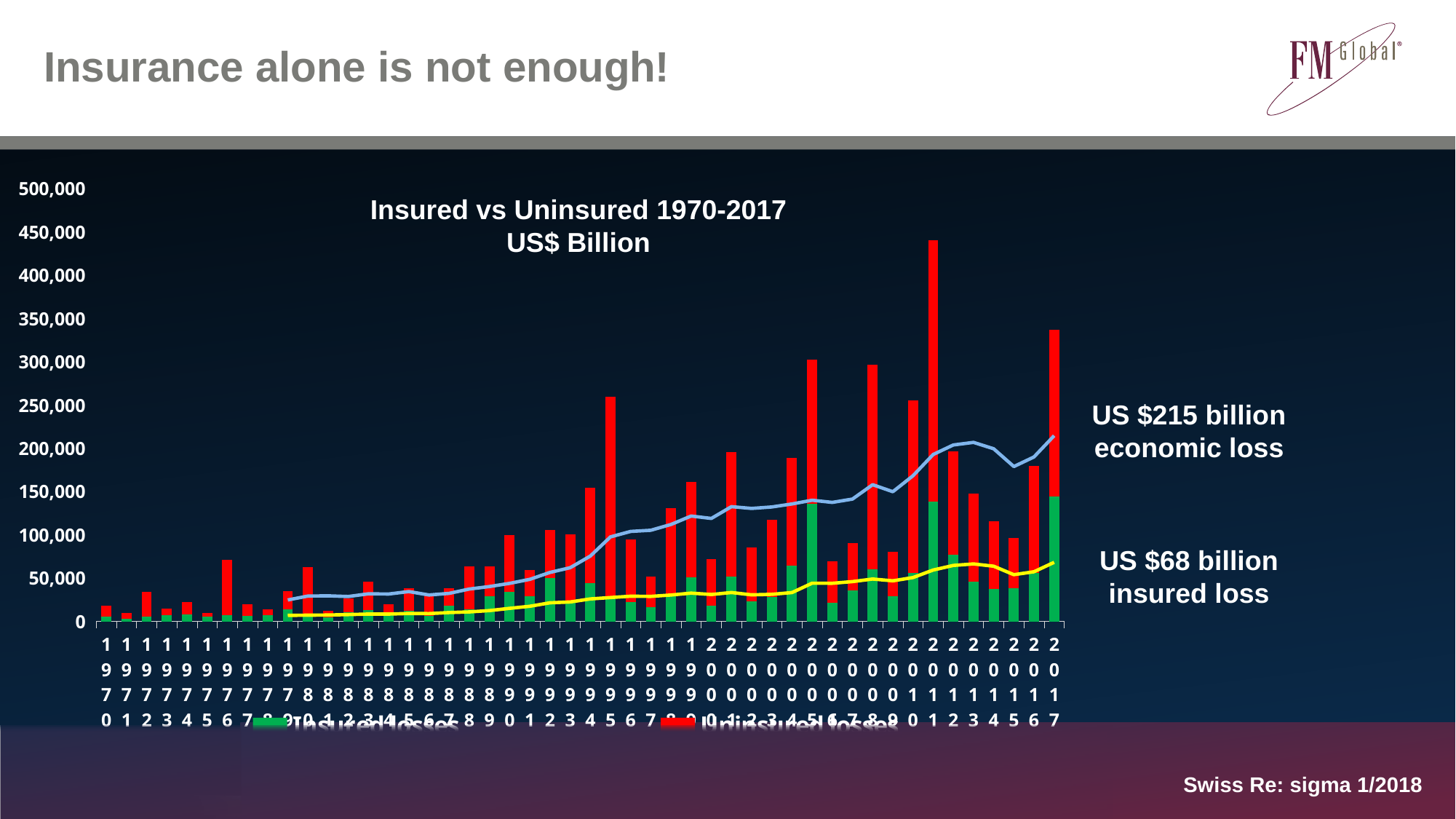
What kind of chart is shown on the slide? bar and line chart Is the total bar value for 2017 greater or less than 300,000? greater What economic loss figure is annotated next to the chart? US $215 billion Do the bar values generally rise or fall from 1970 to 2017? rise Is the total bar value for 1970 greater or less than 50,000? less Which year has the tallest bar in the chart? 2011 What is the title of the chart? Insured vs Uninsured 1970-2017 US$ Billion Which year has the larger total bar, 2011 or 2017? 2011 Is the total bar value for 2012 greater or less than 250,000? less Which year has the larger total bar, 2004 or 2005? 2005 How many years are plotted along the x axis of the chart? 48